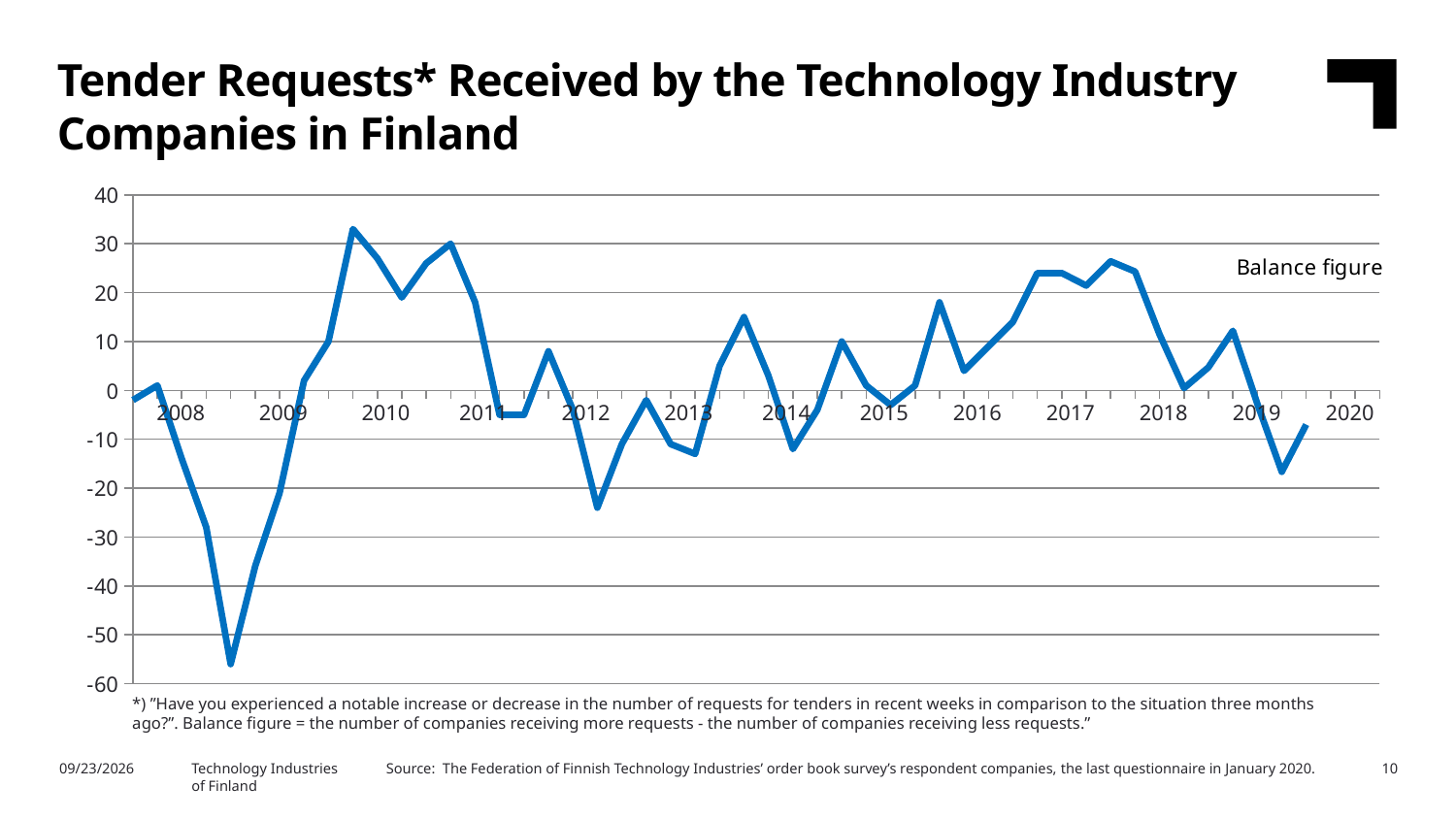
Does the line generally rise or fall from the start of 2018 to the end of 2019? fall What kind of chart is shown on the slide? line chart Is the peak value of the line reached around 2010 greater or less than 30? greater Is the highest value of the line in 2017 greater or less than 20? greater Which is larger: the value of the line at its 2009 low or at its 2012 low? 2012 low Is the lowest value of the line, reached in 2009, greater or less than -50? less In which year does the line reach its lowest point? 2009 What is the title of the chart on the slide? Tender Requests* Received by the Technology Industry Companies in Finland Does the line rise or fall between its low point in 2009 and its peak in 2010? rise What label is shown at the upper right of the plot area describing the plotted measure? Balance figure